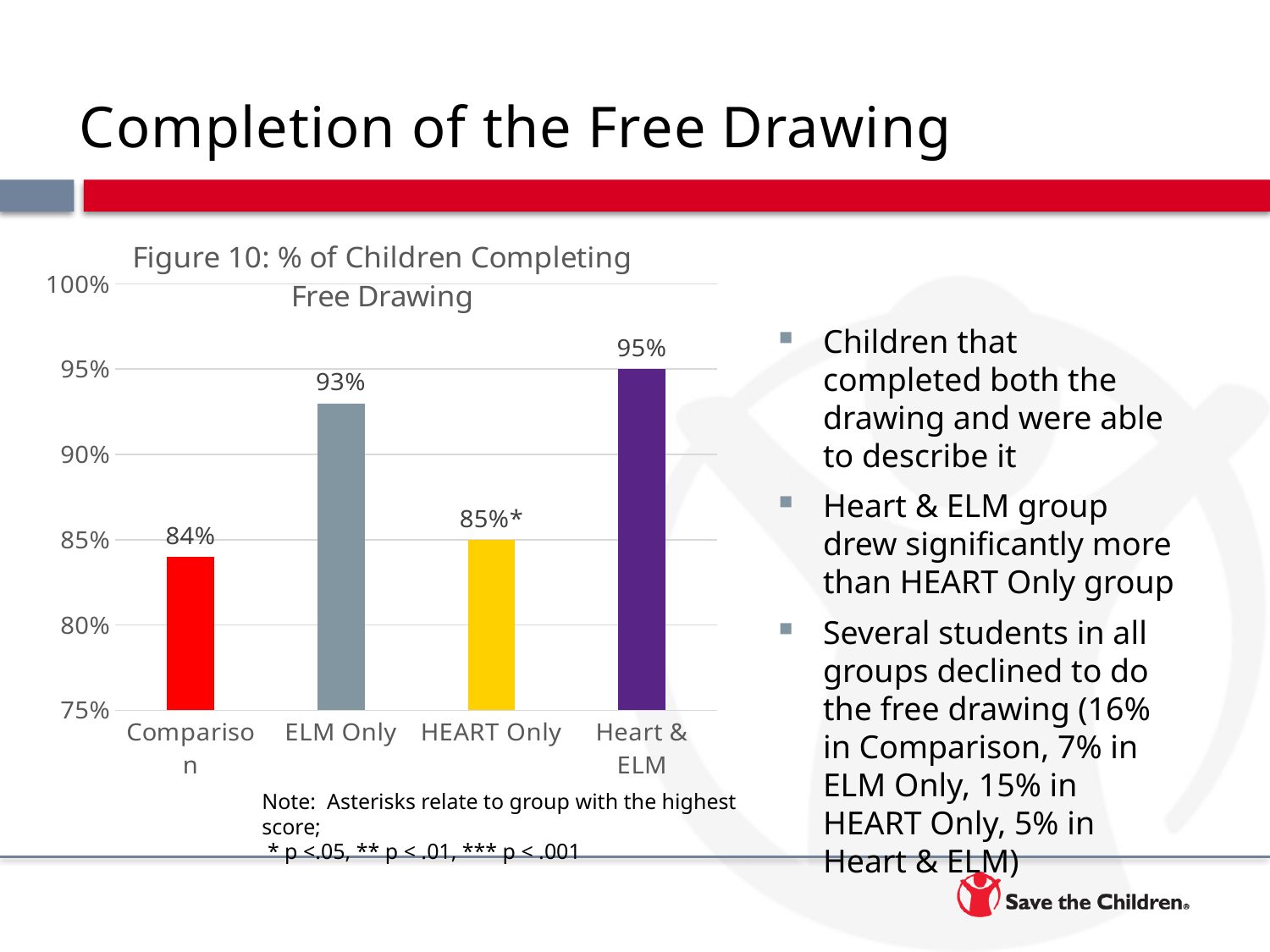
What is the value for Comparison? 84% Which group has the highest percentage of children completing the free drawing? Heart & ELM What is the value for HEART Only? 85% Which is larger, the value for ELM Only or the value for HEART Only? ELM Only What is the difference between the values for Heart & ELM and Comparison? 11% How many groups are shown in the chart? 4 What kind of chart is shown on the slide? Bar chart What is the difference between the values for ELM Only and HEART Only? 8% What is the value for ELM Only? 93% What is the title of the chart? Figure 10: % of Children Completing Free Drawing What is the value for Heart & ELM? 95% Which group has the lowest percentage of children completing the free drawing? Comparison